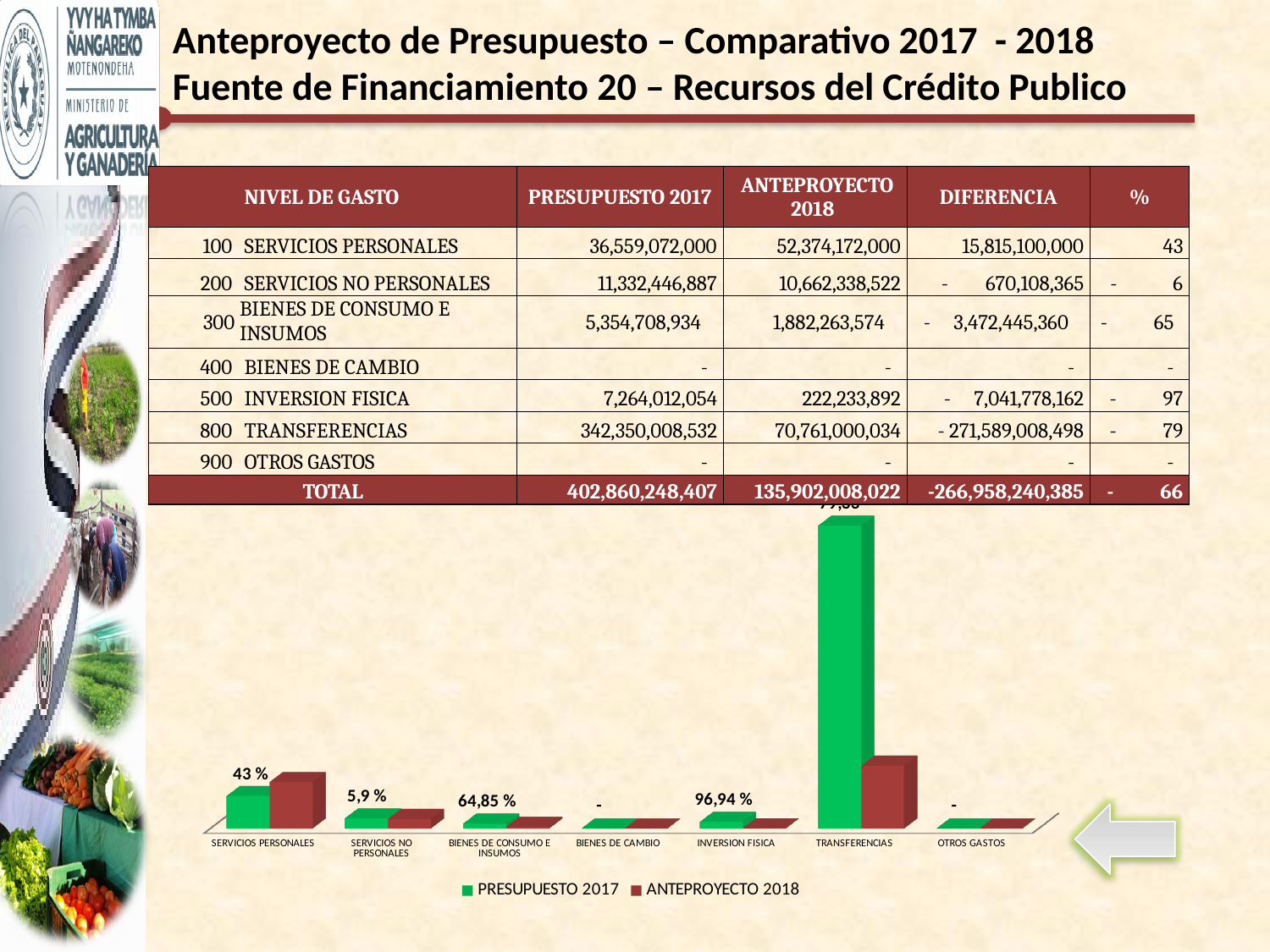
What data label is shown above the bars for SERVICIOS NO PERSONALES in the chart? 5,9 % In the chart, which has the taller PRESUPUESTO 2017 bar: SERVICIOS PERSONALES or SERVICIOS NO PERSONALES? SERVICIOS PERSONALES What data label is shown above the bars for BIENES DE CONSUMO E INSUMOS in the chart? 64,85 % What kind of chart is shown below the table on the slide? bar chart How many categories are shown along the x axis of the chart? 7 For TRANSFERENCIAS in the chart, which series has the taller bar: PRESUPUESTO 2017 or ANTEPROYECTO 2018? PRESUPUESTO 2017 Which category has the tallest bar in the chart? TRANSFERENCIAS What data label is shown above the bars for SERVICIOS PERSONALES in the chart? 43 % What data label is shown above the bars for INVERSION FISICA in the chart? 96,94 % What are the two series names listed in the chart legend? PRESUPUESTO 2017 and ANTEPROYECTO 2018 How many series does the chart legend list? 2 What colour represents the PRESUPUESTO 2017 series in the chart legend? green